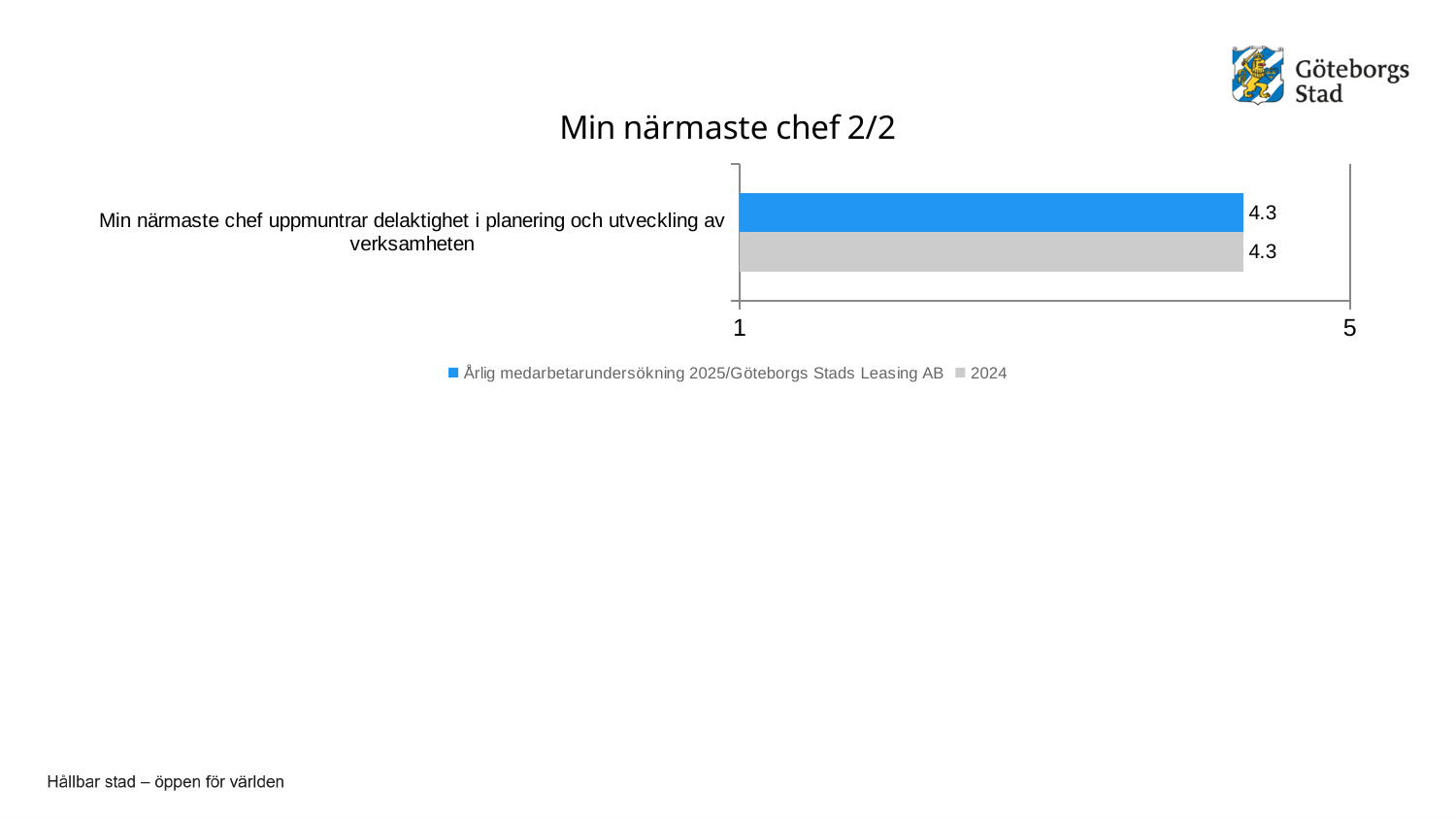
What is the title of the chart? Min närmaste chef 2/2 How many categories (statements) are plotted in the chart? 1 Which colour represents the 2024 series in the chart? Grey What kind of chart is shown on the slide? Bar chart What is the maximum value shown on the horizontal axis? 5 What is the difference between the 2025 value and the 2024 value for the statement shown? 0 What is the value for 'Årlig medarbetarundersökning 2025/Göteborgs Stads Leasing AB' on the statement 'Min närmaste chef uppmuntrar delaktighet i planering och utveckling av verksamheten'? 4.3 What is the value for 2024 on the statement 'Min närmaste chef uppmuntrar delaktighet i planering och utveckling av verksamheten'? 4.3 How many series does the legend list? 2 Is the 2024 value for the statement greater or less than 3? greater